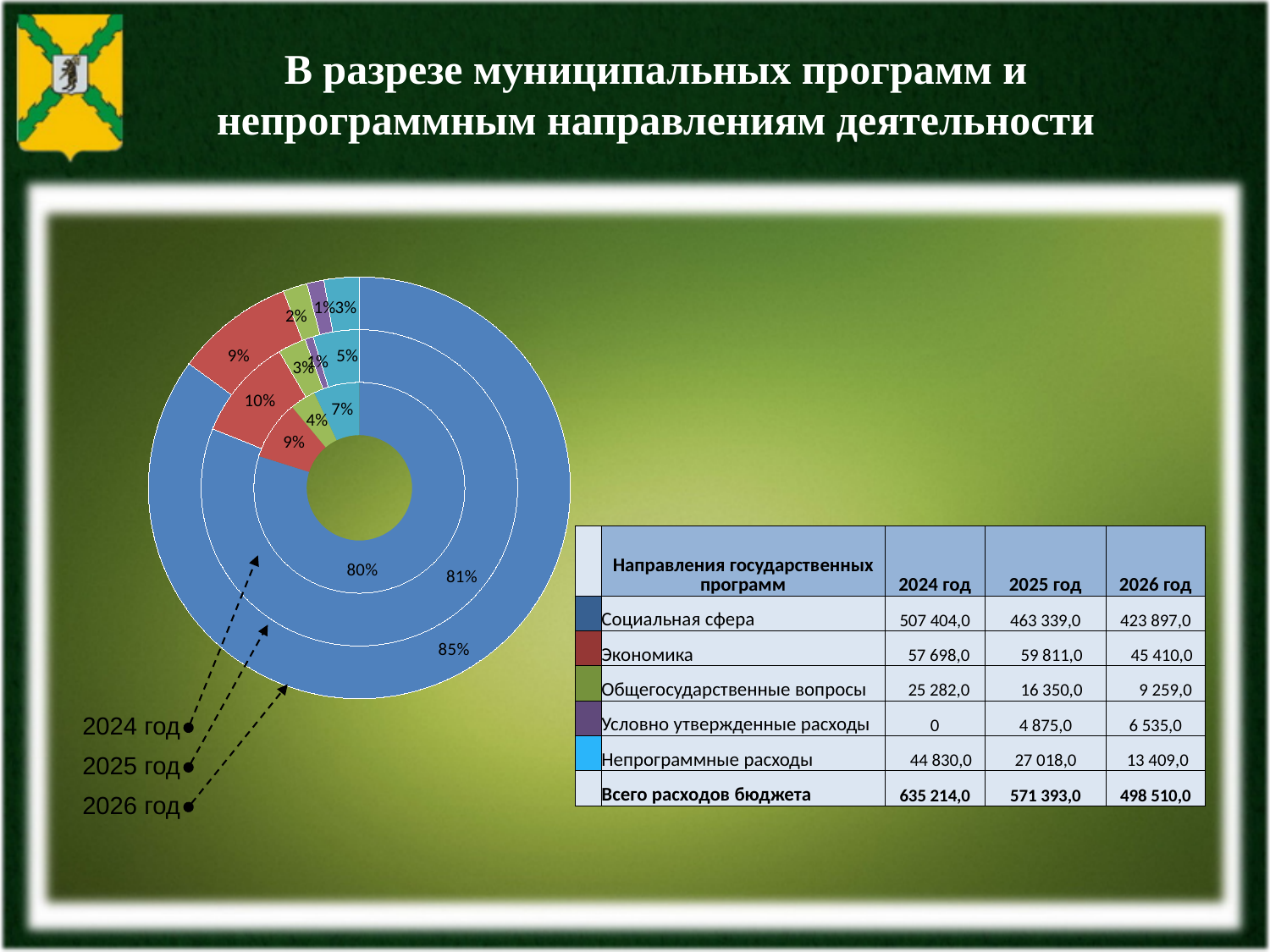
What share of the 2025 budget does Экономика take in the chart? 10% What type of chart is shown on the slide? Doughnut chart How many rings (years) does the doughnut chart contain? 3 Which is larger in the chart: the share of Экономика in 2025 or in 2026? 2025 (10%) What share of the 2024 budget does Социальная сфера take in the chart? 80% What share of the 2026 budget does Социальная сфера take in the chart? 85% Which category has the largest share in every ring of the chart? Социальная сфера What share of the 2024 budget do Непрограммные расходы take in the chart? 7% By how many percentage points does the share of Социальная сфера in 2026 exceed its share in 2024? 5 How many spending categories (colour swatches) are listed in the table that serves as the chart legend? 5 Which colour represents Социальная сфера in the chart? Blue Does the share of Непрограммные расходы rise or fall from 2024 to 2026 in the chart? Fall